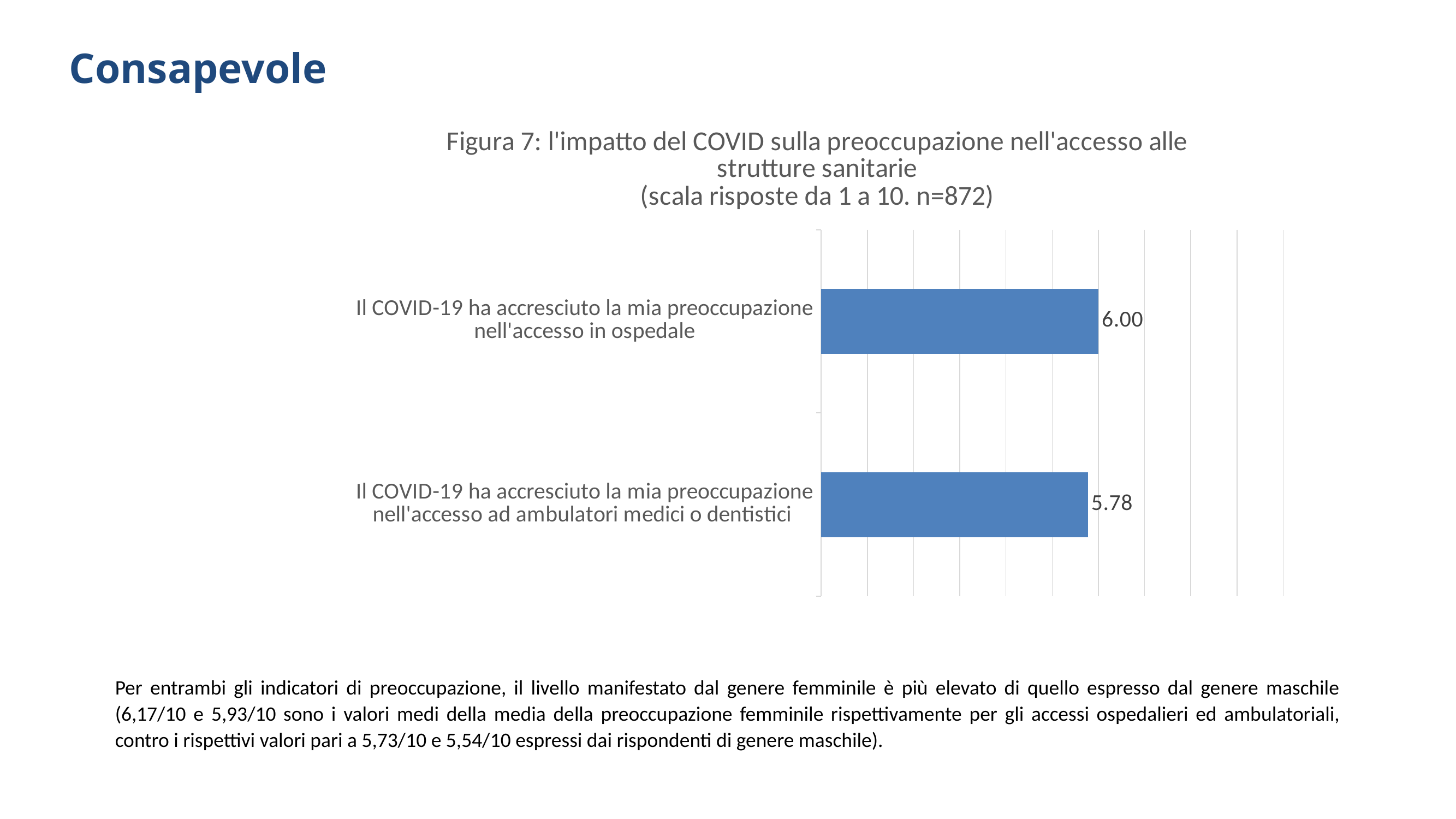
Which category has the highest value? Il COVID-19 ha accresciuto la mia preoccupazione nell'accesso in ospedale What is the title of the chart? Figura 7: l'impatto del COVID sulla preoccupazione nell'accesso alle strutture sanitarie (scala risposte da 1 a 10. n=872) According to the chart title, how many respondents (n) are included? 872 How many categories are shown in the chart? 2 What is the value for "Il COVID-19 ha accresciuto la mia preoccupazione nell'accesso ad ambulatori medici o dentistici"? 5.78 What colour are the bars in the chart? Blue What is the difference between the value for access to hospital (ospedale) and the value for access to medical or dental clinics (ambulatori medici o dentistici)? 0.22 Which is larger: the value for access to hospital (ospedale) or the value for access to medical or dental clinics (ambulatori medici o dentistici)? Access to hospital (ospedale) What kind of chart is shown on the slide? Bar chart What is the value for "Il COVID-19 ha accresciuto la mia preoccupazione nell'accesso in ospedale"? 6.00 Which category has the lowest value? Il COVID-19 ha accresciuto la mia preoccupazione nell'accesso ad ambulatori medici o dentistici